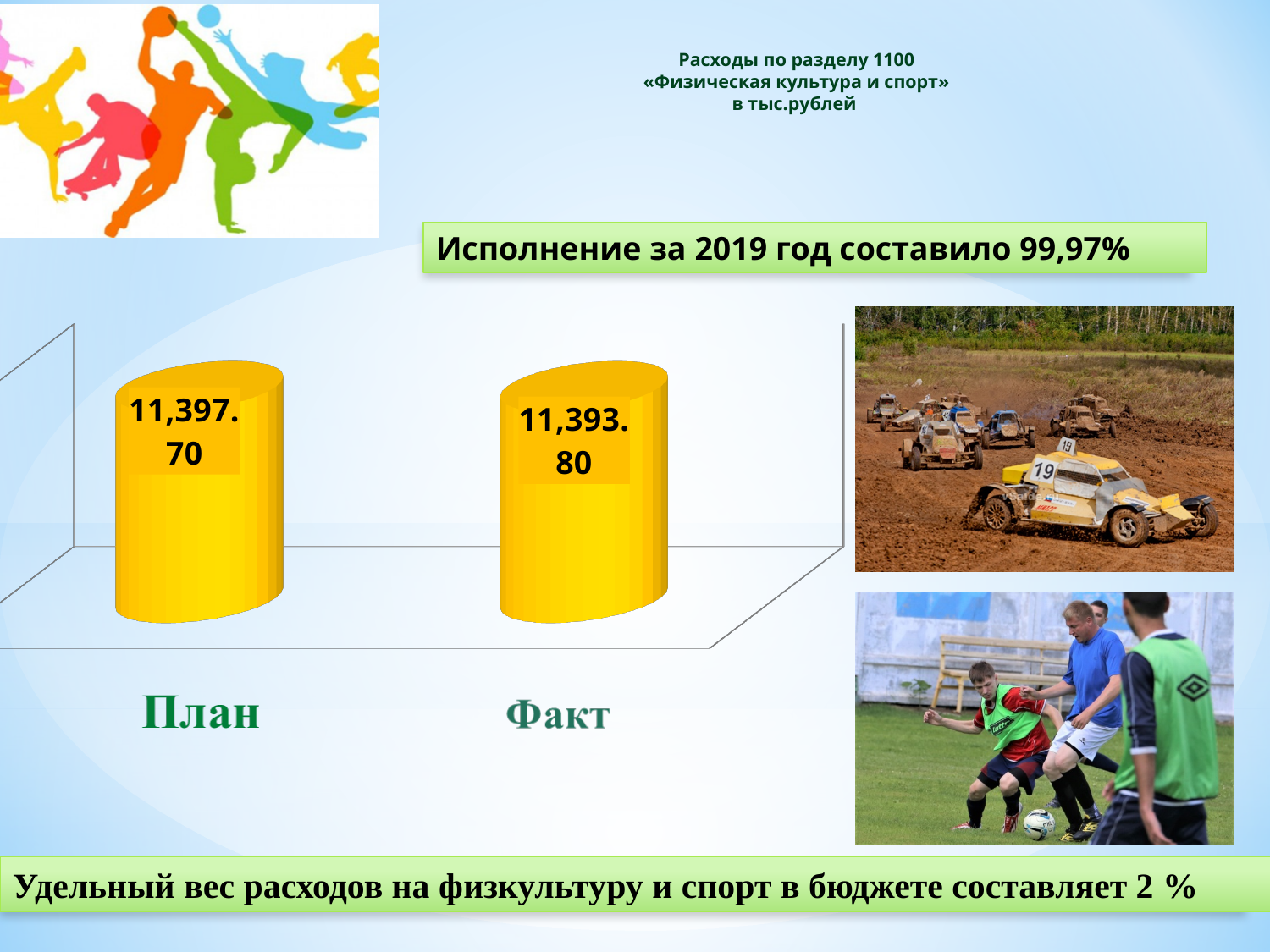
What is the difference between the План value and the Факт value? 3.90 What are the category labels on the chart's x axis? План, Факт What is the value for Факт (Fact) on the chart? 11,393.80 In what units are the chart values expressed, according to the slide title? тыс.рублей Which category has the higher value, План or Факт? План Which category has the lowest value on the chart? Факт How many categories are shown on the chart? 2 Which category has the highest value on the chart? План What is the value for План (Plan) on the chart? 11,397.70 What kind of chart is shown on the slide? Bar chart